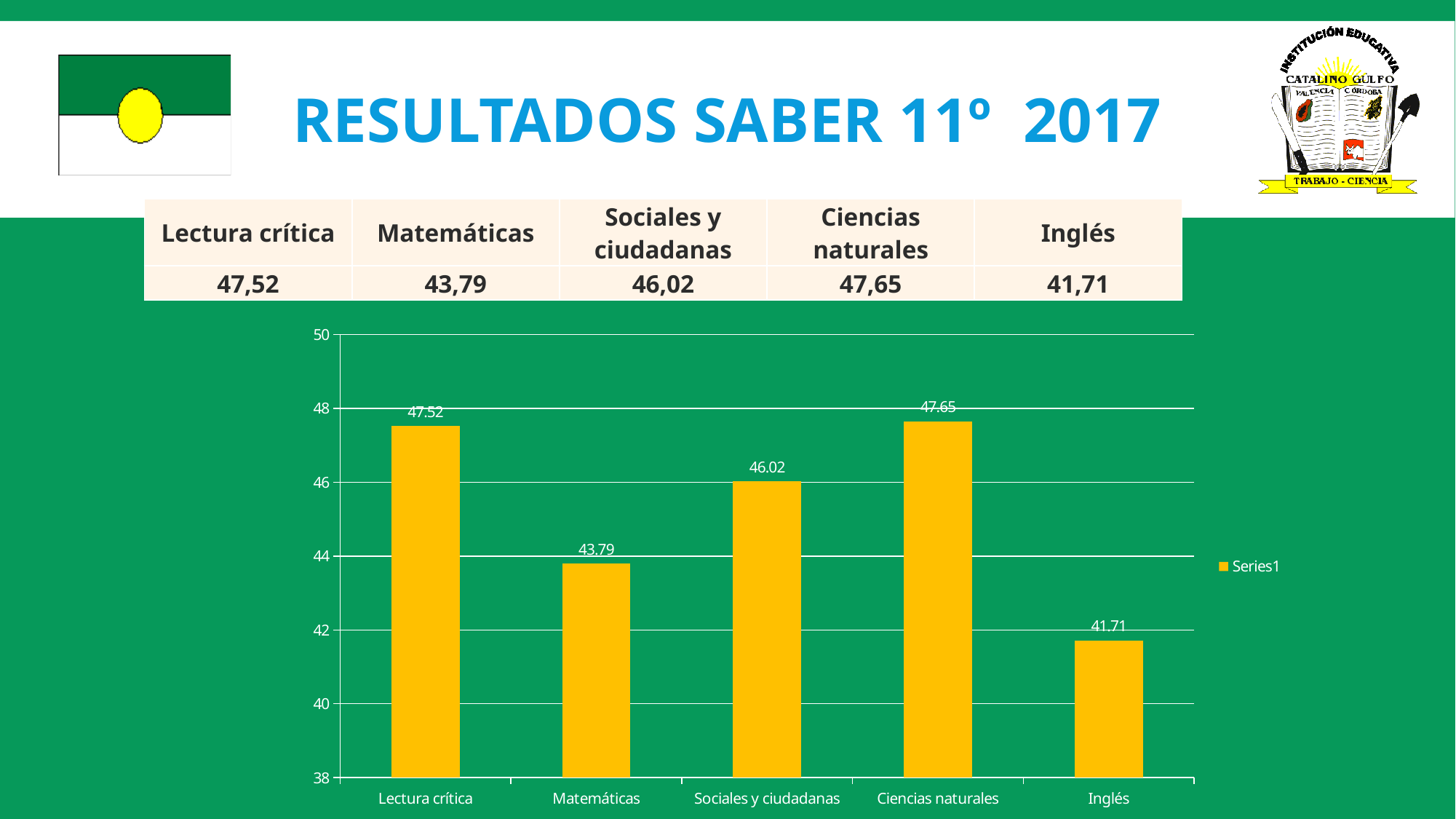
How many series does the chart legend list? 1 How many categories are shown on the x axis of the bar chart? 5 What kind of chart is shown on the slide? bar chart What is the difference between the values for Sociales y ciudadanas and Inglés? 4.31 What is the difference between the values for Ciencias naturales and Lectura crítica? 0.13 Is the value for Matemáticas greater or less than 44? less Which category has the highest value in the bar chart? Ciencias naturales What is the value for Matemáticas in the bar chart? 43.79 What is the value for Inglés in the bar chart? 41.71 Which is larger, the value for Sociales y ciudadanas or the value for Matemáticas? Sociales y ciudadanas What is the value for Lectura crítica in the bar chart? 47.52 Which category has the lowest value in the bar chart? Inglés